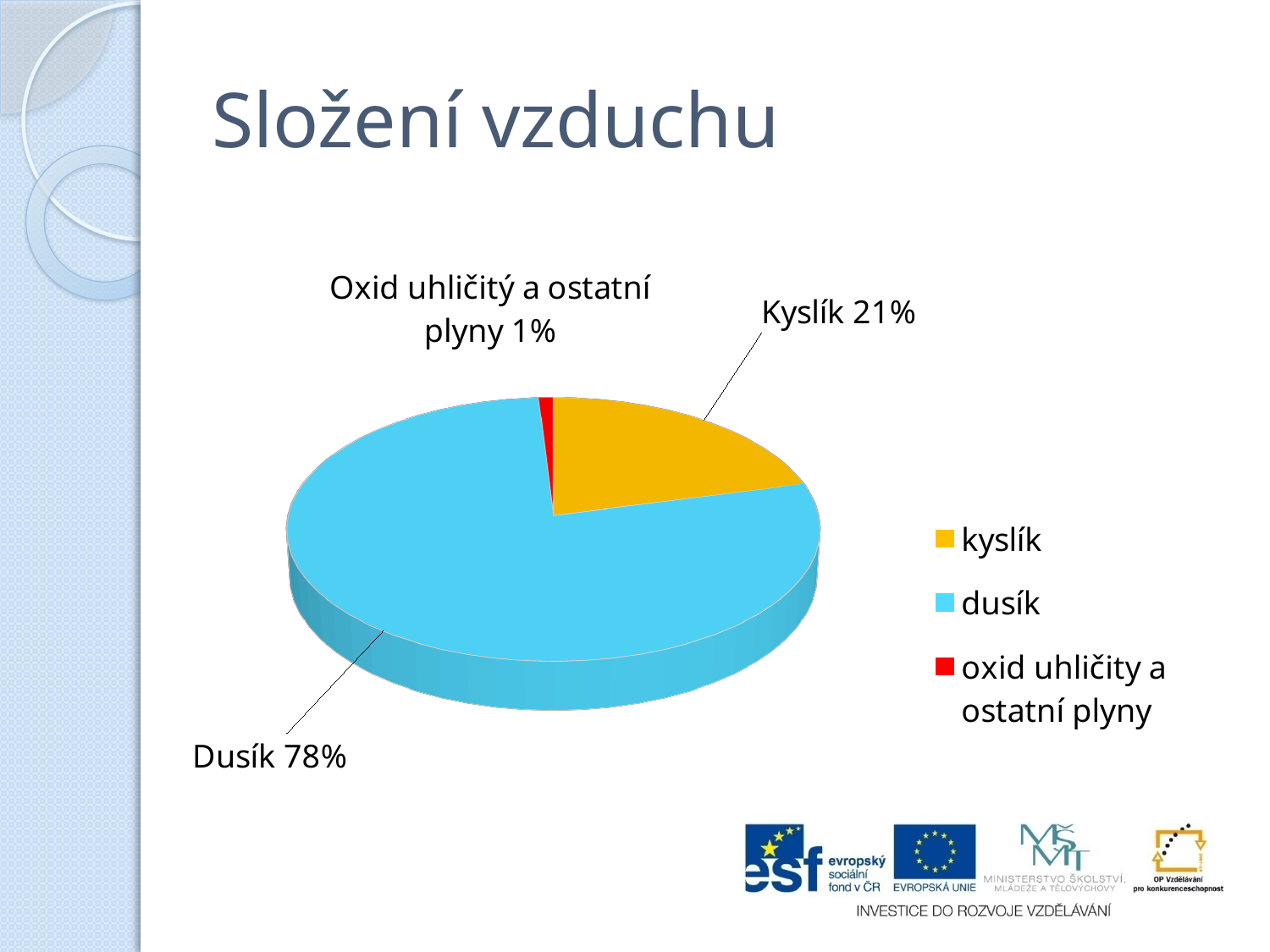
What is the title of the slide? Složení vzduchu Which slice of the pie is the smallest? Oxid uhličitý a ostatní plyny What colour is the slice for dusík? light blue How many entries does the legend list? 3 What is the difference in percentage points between Dusík and Kyslík? 57 What share of the pie does Oxid uhličitý a ostatní plyny have? 1% What share of the pie does Dusík have? 78% Which slice of the pie is the largest? Dusík How many slices does the pie chart have? 3 What kind of chart is shown on the slide? pie chart Which is larger, the share for Kyslík or the share for Oxid uhličitý a ostatní plyny? Kyslík What share of the pie does Kyslík have? 21%